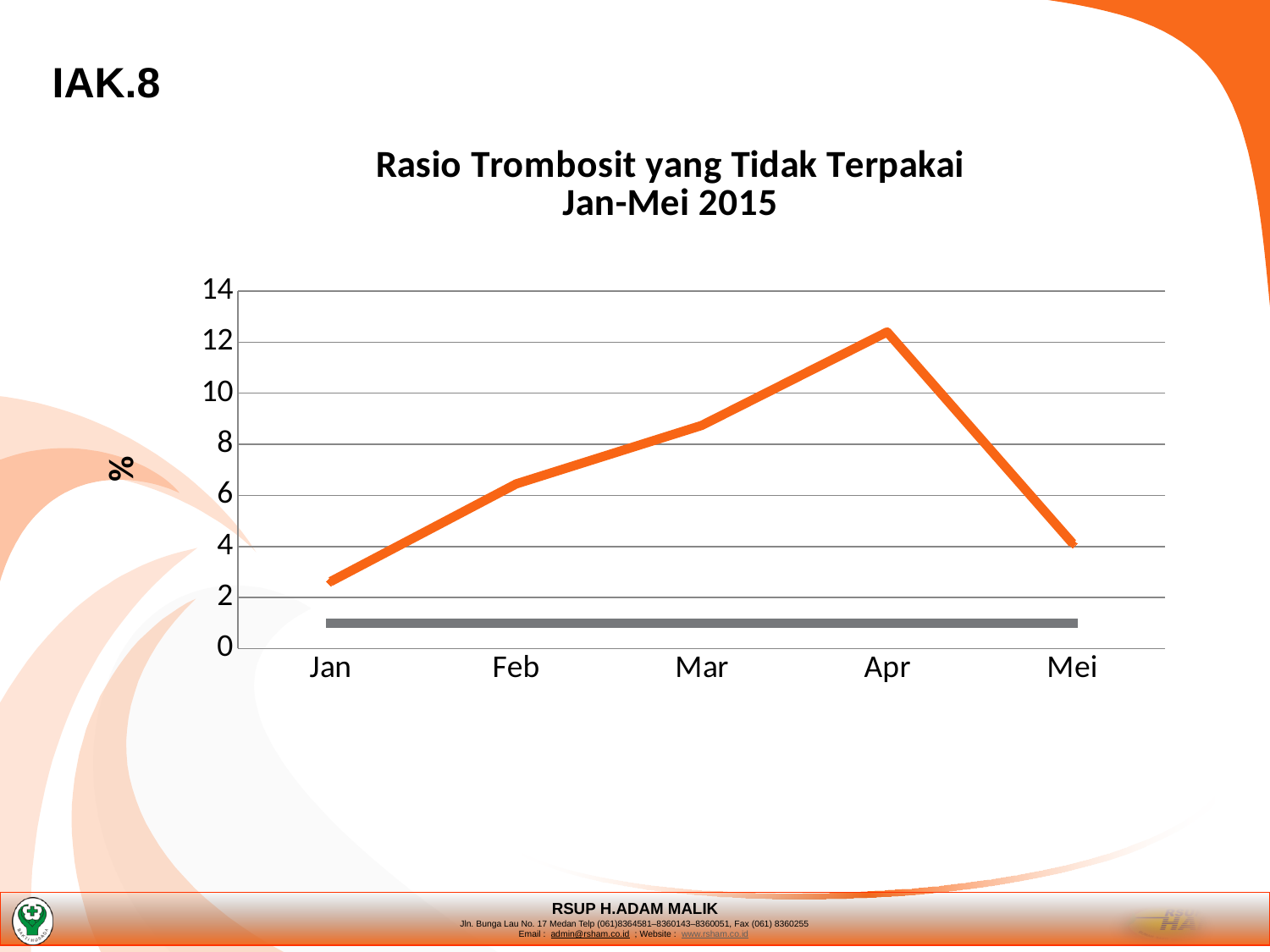
In which month is the orange line at its lowest value? Jan Is the value of the orange line for Feb greater or less than 8? less Is the value of the orange line for Apr greater or less than 12? greater What is the title of the chart? Rasio Trombosit yang Tidak Terpakai Jan-Mei 2015 What label is shown on the vertical axis? % Is the value of the orange line for Mar greater or less than 8? greater Which month has the larger value on the orange line, Feb or Mei? Feb What kind of chart is shown on the slide? line chart How many months are plotted along the x axis? 5 In which month does the orange line reach its highest value? Apr Does the orange line rise or fall from Jan to Apr? rise